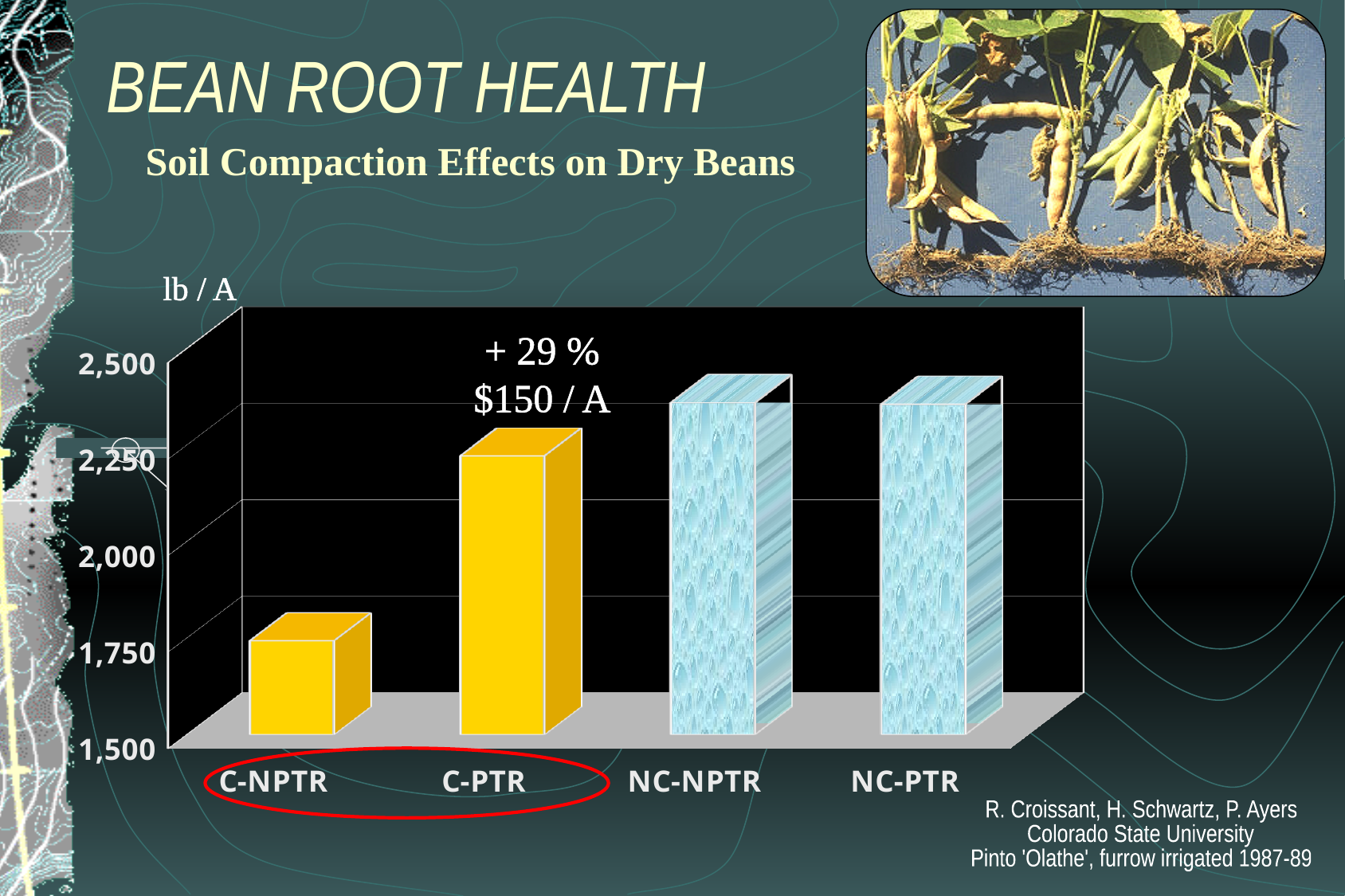
Is the value for C-PTR greater or less than 2,500? less How many categories are plotted on the chart? 4 Is the value for NC-PTR greater or less than 2,250? greater What unit is shown on the vertical axis of the chart? lb / A Which is larger, the value for NC-NPTR or the value for C-PTR? NC-NPTR Which category has the lowest value on the chart? C-NPTR What percentage increase is annotated above the C-PTR bar? + 29 % Is the value for C-NPTR greater or less than 2,000? less Which is larger, the value for C-PTR or the value for C-NPTR? C-PTR What kind of chart is shown on the slide? bar chart